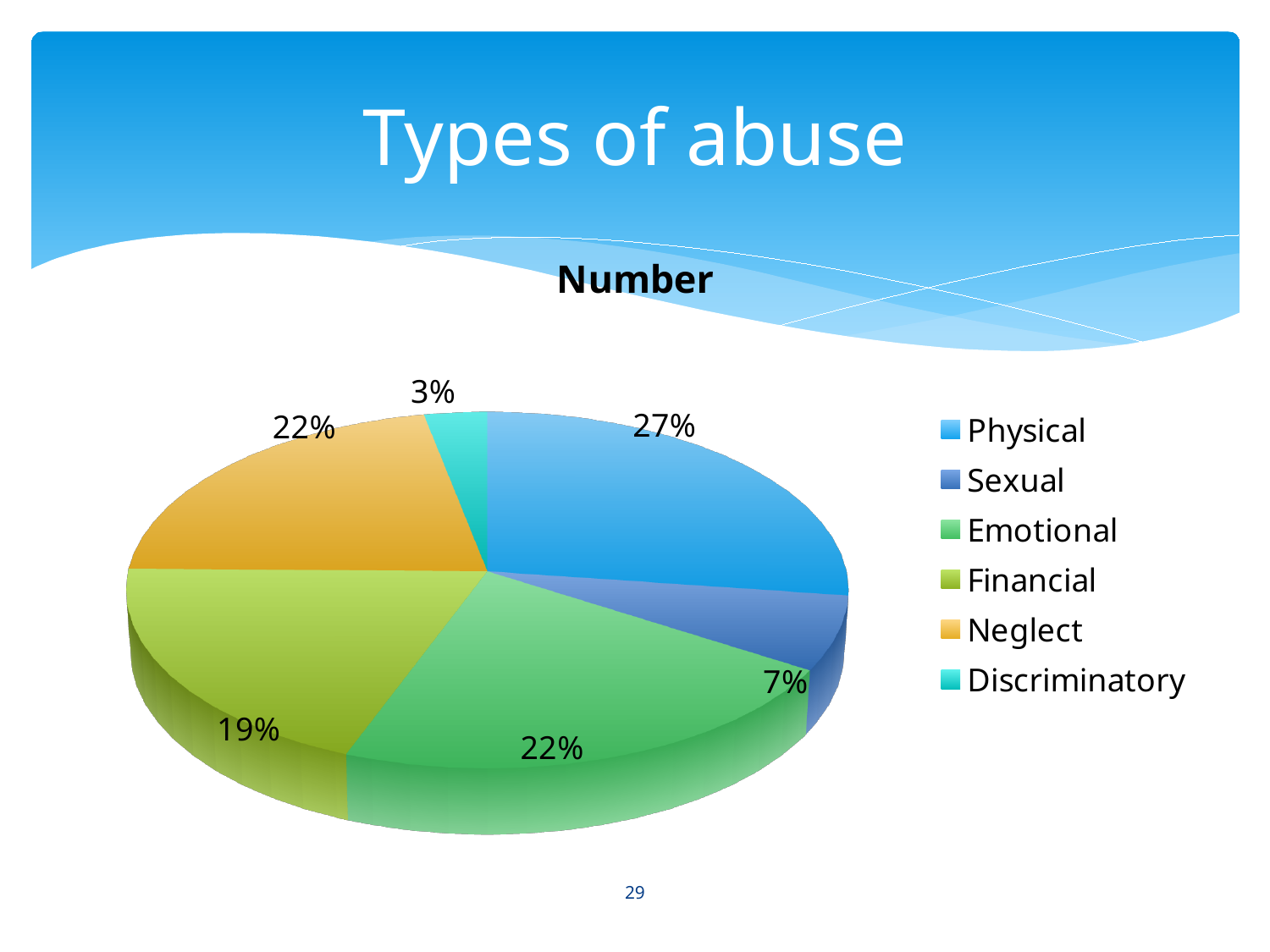
Which type of abuse has the largest slice of the pie? Physical What is the title of the chart? Number How many percentage points larger is the Physical slice than the Sexual slice? 20 What kind of chart is shown on the slide? Pie chart What is the combined percentage of the Emotional and Neglect slices? 44% Which is larger, the Financial slice or the Neglect slice? Neglect What share of the pie is Financial abuse? 19% How many categories are shown in the pie chart? 6 Which type of abuse has the smallest slice of the pie? Discriminatory What percentage is labelled for Discriminatory abuse? 3% What percentage of the pie does Physical abuse account for? 27% What percentage is shown for Sexual abuse? 7%